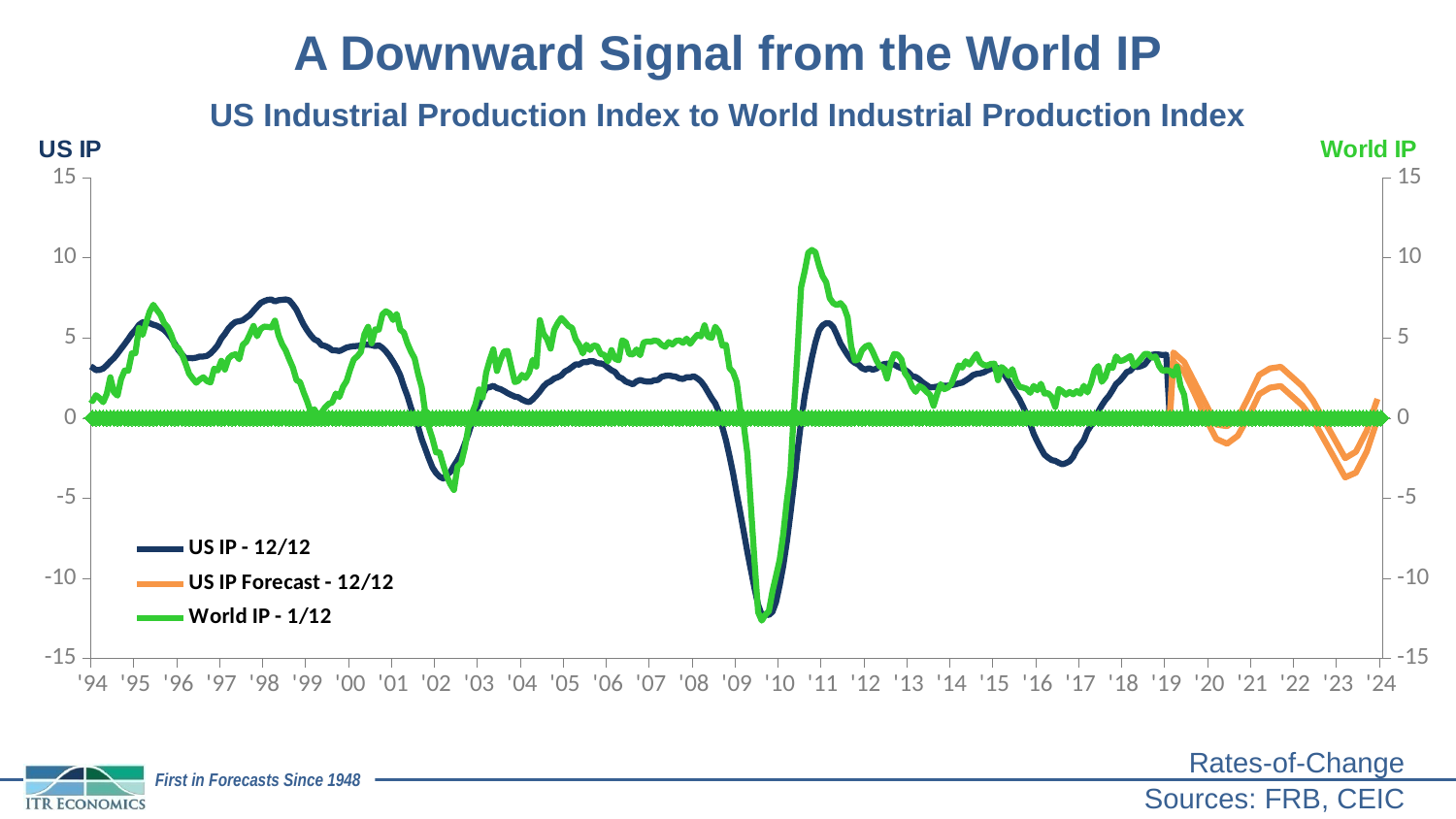
What kind of chart is shown on the slide? line chart Is the trough of the US IP - 12/12 line around '16 greater or less than -5? greater Does the US IP Forecast - 12/12 line rise or fall from '22 to '23? fall Is the peak of the World IP - 1/12 line around '11 greater or less than 5? greater In which year does the US IP - 12/12 line reach its lowest point? '09 Is the World IP - 1/12 line around '02 greater or less than 0? less What are the three series named in the legend? US IP - 12/12, US IP Forecast - 12/12, World IP - 1/12 At the peak around '11, which line is higher, US IP - 12/12 or World IP - 1/12? World IP - 1/12 What is the title of the chart? US Industrial Production Index to World Industrial Production Index How many year labels are shown on the x axis? 31 How many series does the legend list? 3